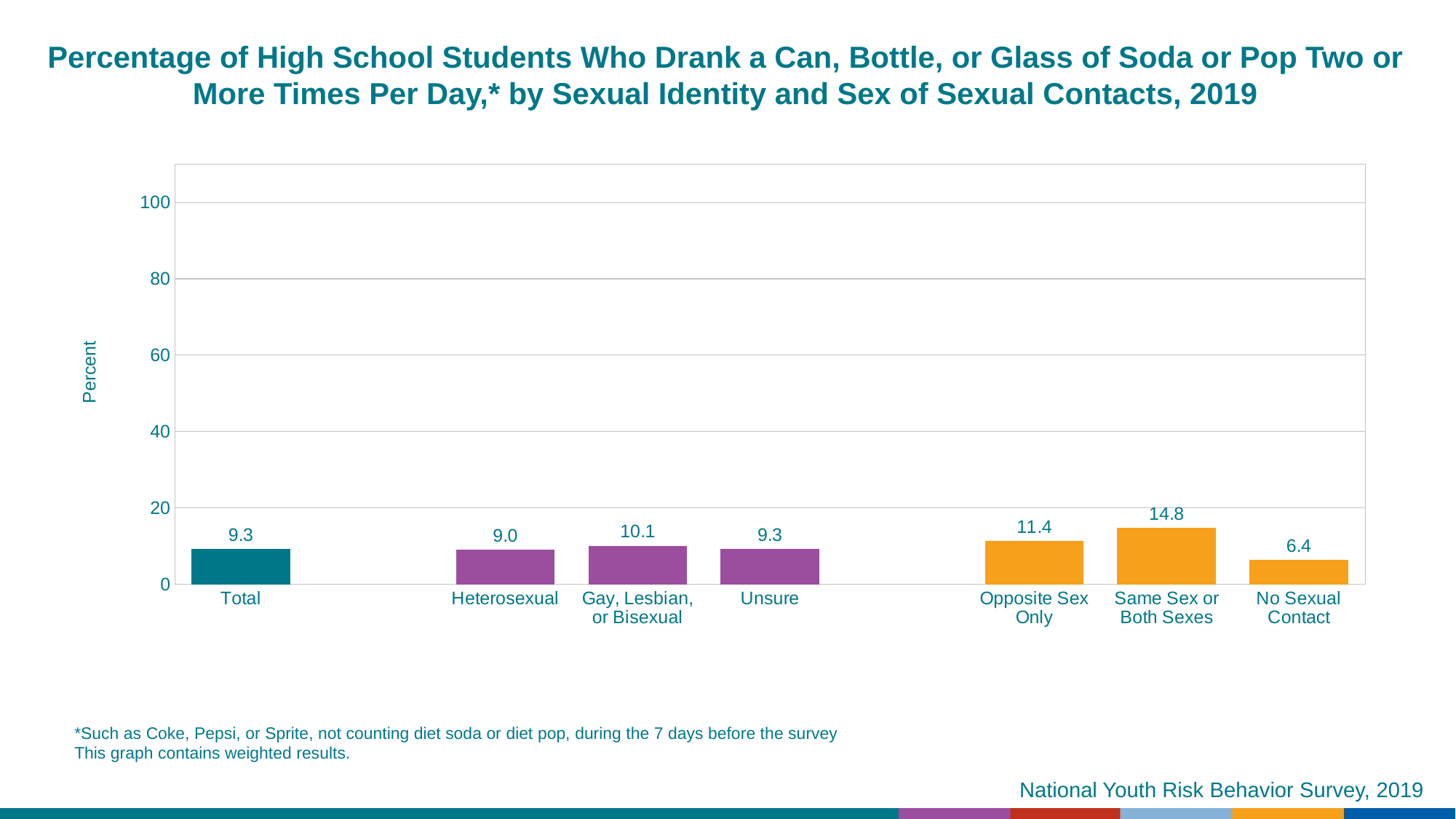
Which is larger, the value for Gay, Lesbian, or Bisexual or the value for Heterosexual? Gay, Lesbian, or Bisexual What kind of chart is this? Bar chart Which category has the highest value? Same Sex or Both Sexes Is the value for Same Sex or Both Sexes greater or less than 20? less What is the value for No Sexual Contact? 6.4 What is the value for Same Sex or Both Sexes? 14.8 What is the difference between the values for Same Sex or Both Sexes and Opposite Sex Only? 3.4 What is the value for Gay, Lesbian, or Bisexual? 10.1 Which category has the lowest value? No Sexual Contact How many categories are shown on the x axis? 7 What is the value for Heterosexual? 9.0 What is the value for Total? 9.3